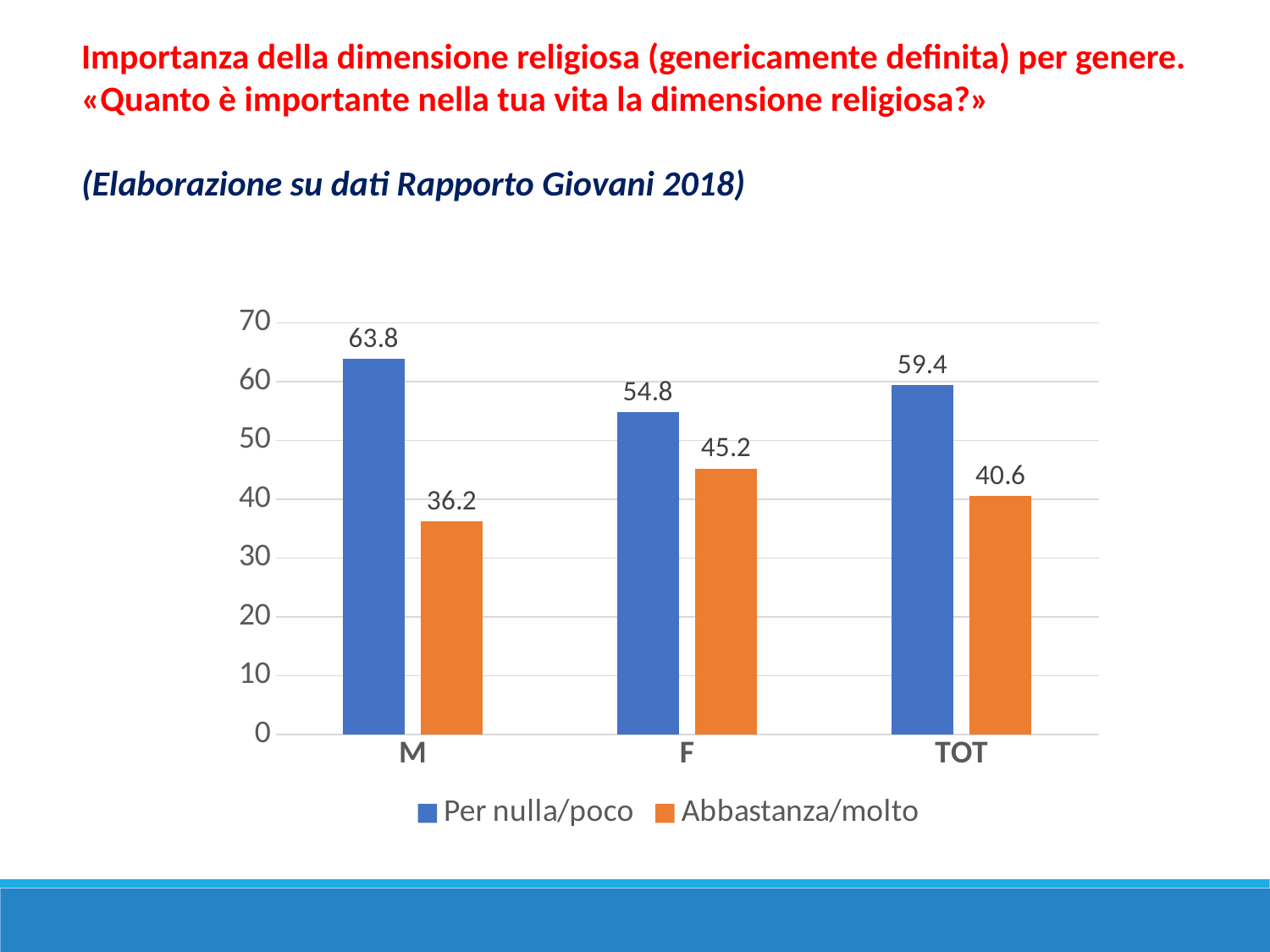
What is the value for 'Abbastanza/molto' in category F? 45.2 How many categories are shown on the x axis? 3 Which category has the highest value for 'Per nulla/poco'? M What kind of chart is shown on the slide? bar chart What colour are the 'Abbastanza/molto' bars? orange What is the difference between 'Per nulla/poco' and 'Abbastanza/molto' in category M? 27.6 Which is larger in category F: 'Per nulla/poco' or 'Abbastanza/molto'? Per nulla/poco Is the value for 'Per nulla/poco' in category TOT greater or less than 50? greater Which category has the lowest value for 'Abbastanza/molto'? M How many series does the legend list? 2 What is the value for 'Per nulla/poco' in category M? 63.8 What is the value for 'Abbastanza/molto' in category TOT? 40.6